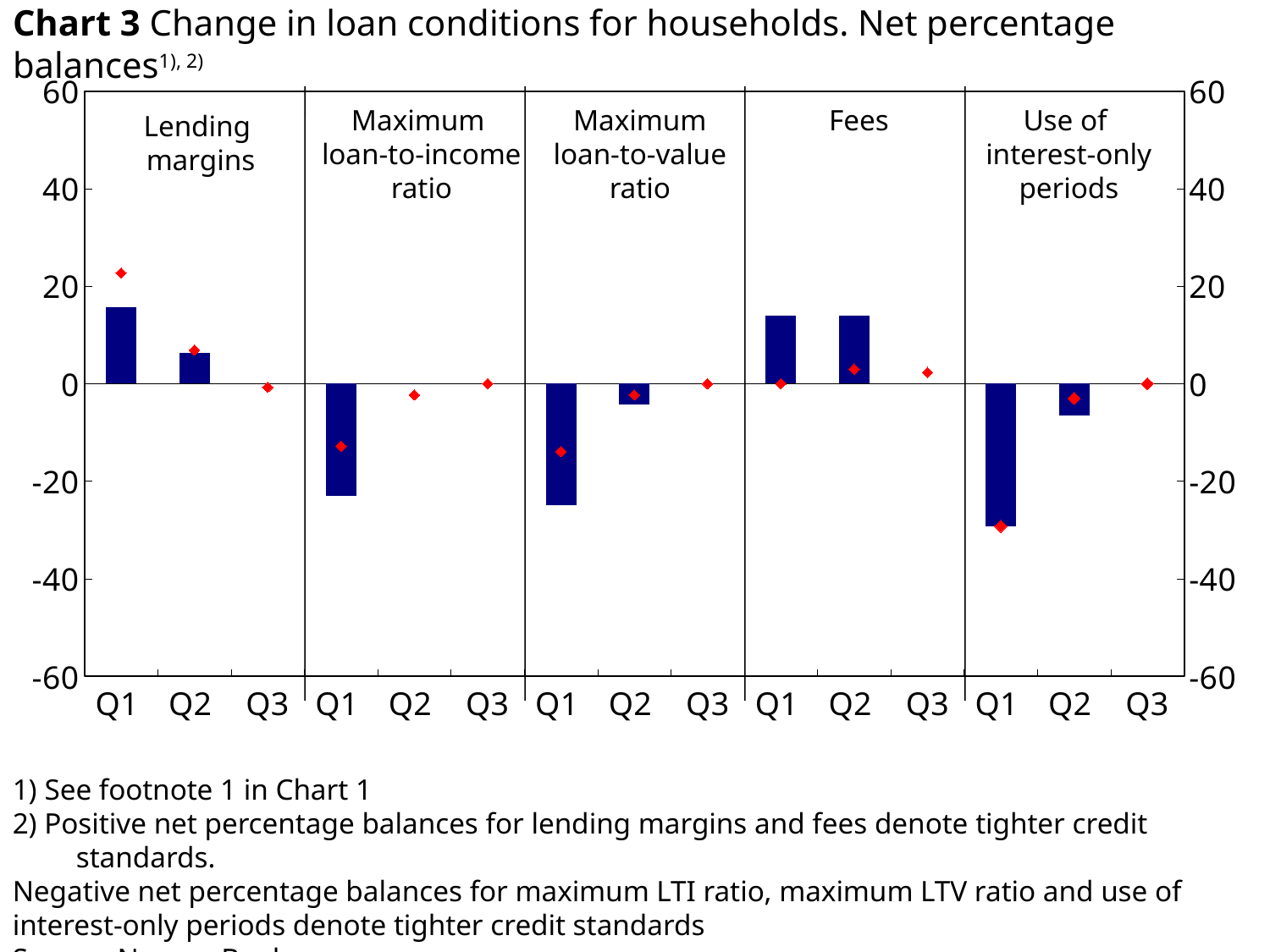
How many quarters are shown in each panel of the chart? 3 Which panel and quarter has the lowest bar in the whole chart? Use of interest-only periods, Q1 How many loan condition panels does the chart show? 5 In the Use of interest-only periods panel, is the bar for Q1 greater or less than -20? less In the Maximum loan-to-income ratio panel, is the bar for Q1 greater or less than -20? less In the Lending margins panel, which quarter has the higher bar, Q1 or Q2? Q1 In the Use of interest-only periods panel, which quarter has the lower bar, Q1 or Q2? Q1 What kind of chart is shown on the slide? combination bar and line chart In the Lending margins panel, do the bars rise or fall from Q1 to Q3? fall What is the title of the chart? Chart 3 Change in loan conditions for households. Net percentage balances In the Fees panel, is the bar for Q1 greater or less than 20? less